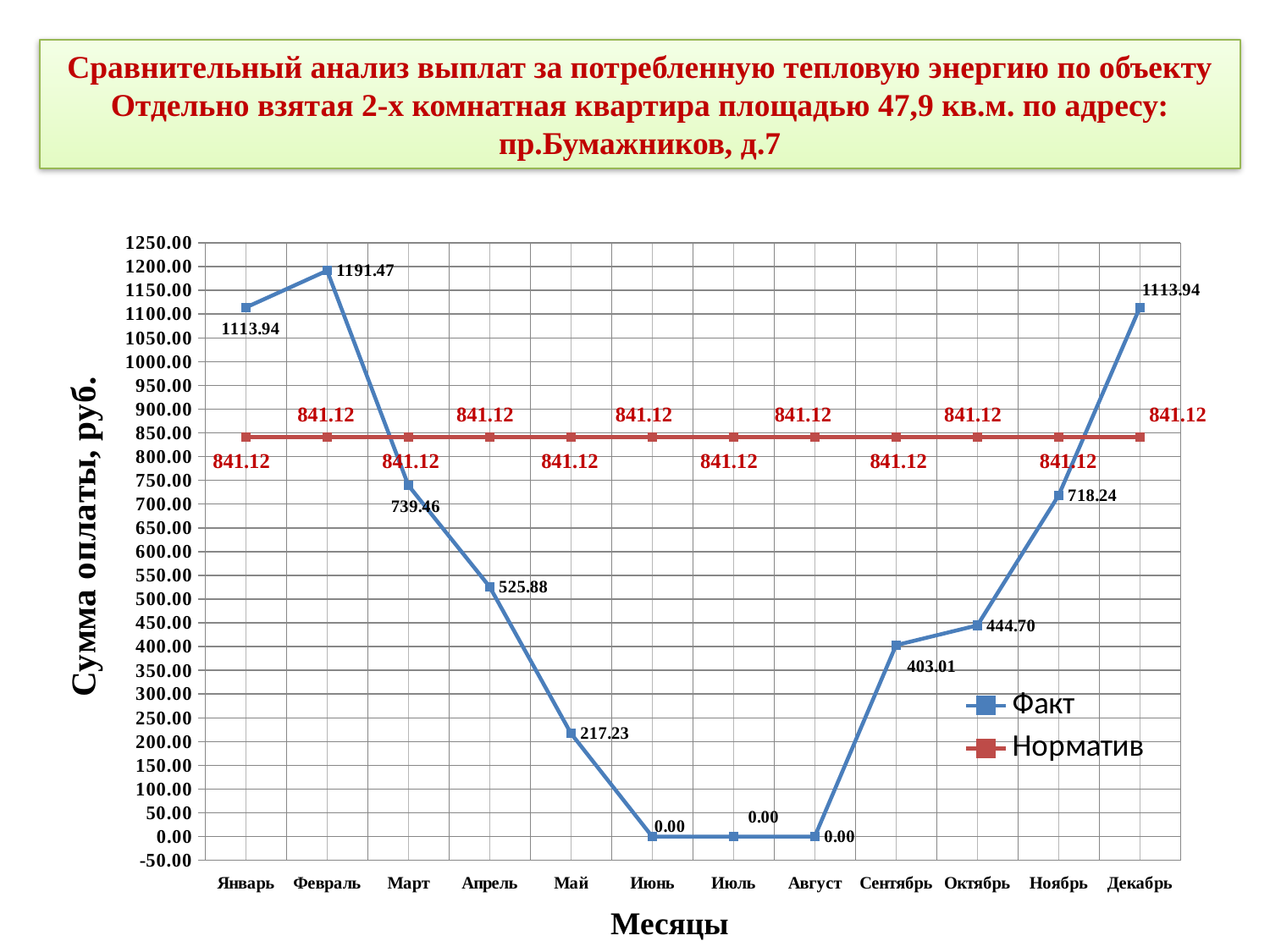
How many series does the legend list? 2 What is the lowest value of the Факт series? 0.00 What is the value of the Факт series for Февраль? 1191.47 What kind of chart is shown on the slide? line chart What is the value of the Норматив series for Сентябрь? 841.12 Is the Факт value for Май greater or less than 250.00? less How many months are shown on the x axis? 12 What is the difference between the Факт values for Февраль and Март? 452.01 Which is larger, the Факт value for Октябрь or the Факт value for Ноябрь? Ноябрь What is the value of the Факт series for Апрель? 525.88 In which month is the Факт series highest? Февраль Does the Факт series rise or fall from Май to Июнь? fall